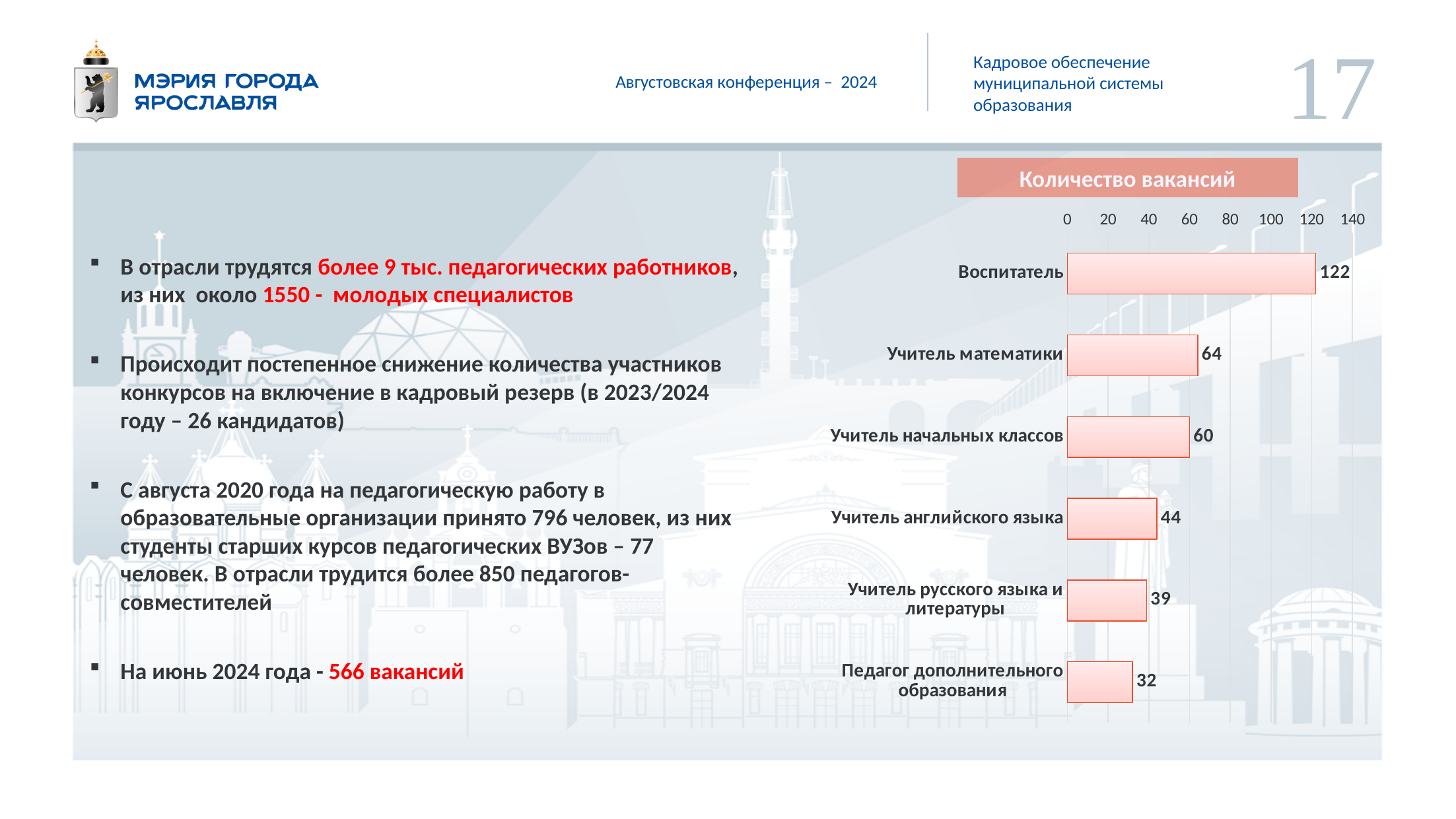
What is the difference in vacancies between Учитель начальных классов and Учитель русского языка и литературы? 21 Which category has the lowest number of vacancies? Педагог дополнительного образования What is the difference in vacancies between Воспитатель and Учитель математики? 58 What is the number of vacancies for Педагог дополнительного образования? 32 What type of chart is shown on the slide? Bar chart What is the number of vacancies for Воспитатель? 122 What is the number of vacancies for Учитель математики? 64 Which has more vacancies: Учитель математики or Учитель начальных классов? Учитель математики Which category has the highest number of vacancies? Воспитатель What is the number of vacancies for Учитель английского языка? 44 How many categories are shown in the chart? 6 What is the title of the chart? Количество вакансий